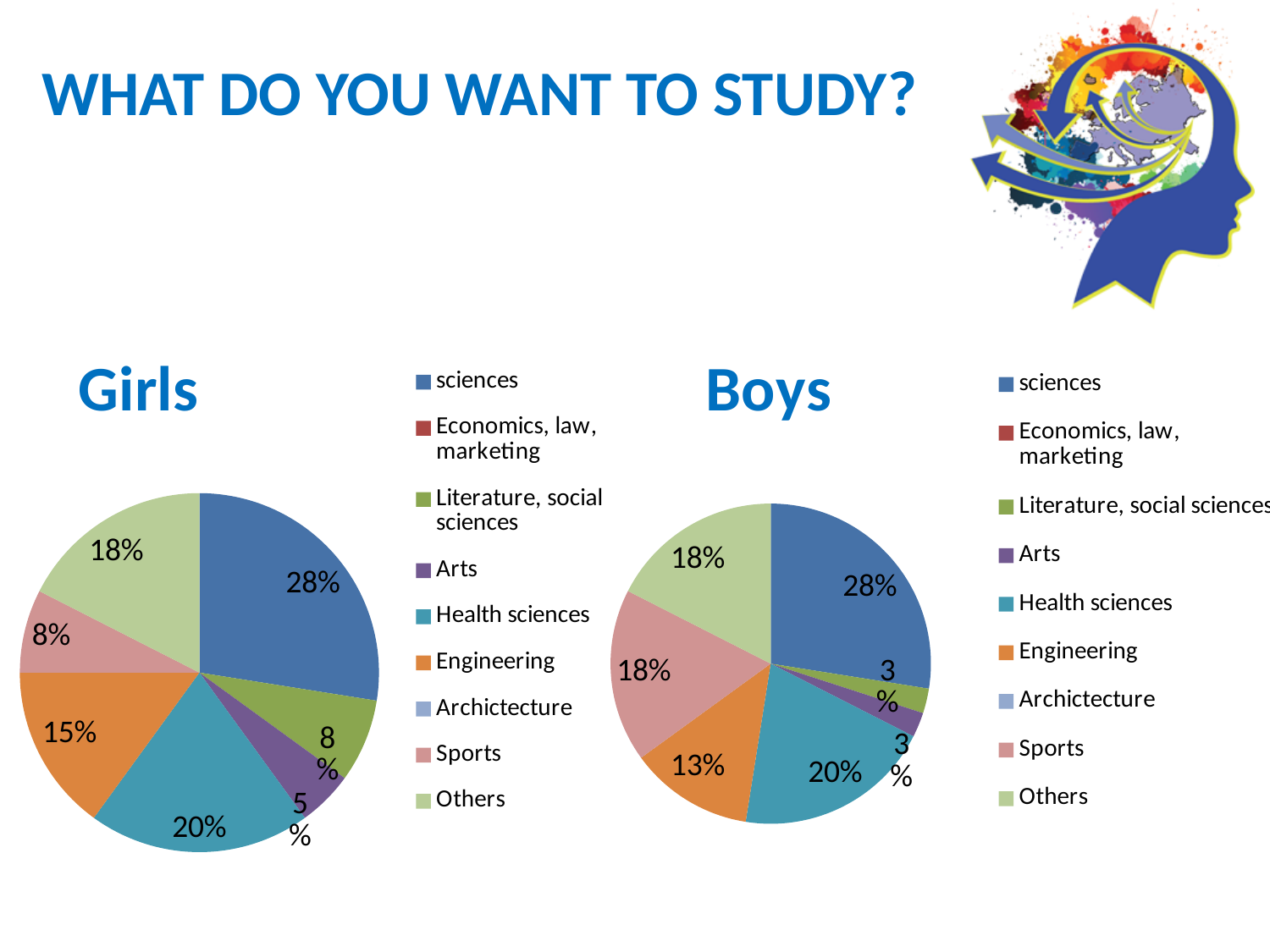
In the Girls pie chart, which category has the largest share? sciences What is the difference between the Engineering share in the Girls pie chart and the Engineering share in the Boys pie chart? 2% How many entries does the legend of the Girls pie chart list? 9 In the Girls pie chart, what percentage of girls want to study sciences? 28% What type of chart is used for the Boys data? Pie chart In the Girls pie chart, which category has the smallest share? Arts In the Boys pie chart, which category has the largest share? sciences In the Girls pie chart, what percentage is shown for Engineering? 15% In the Girls pie chart, what percentage is shown for Health sciences? 20% In the Boys pie chart, what percentage is shown for Engineering? 13% In the Boys pie chart, what percentage is shown for Sports? 18% Which is larger: the Sports share in the Girls pie chart or the Sports share in the Boys pie chart? Boys